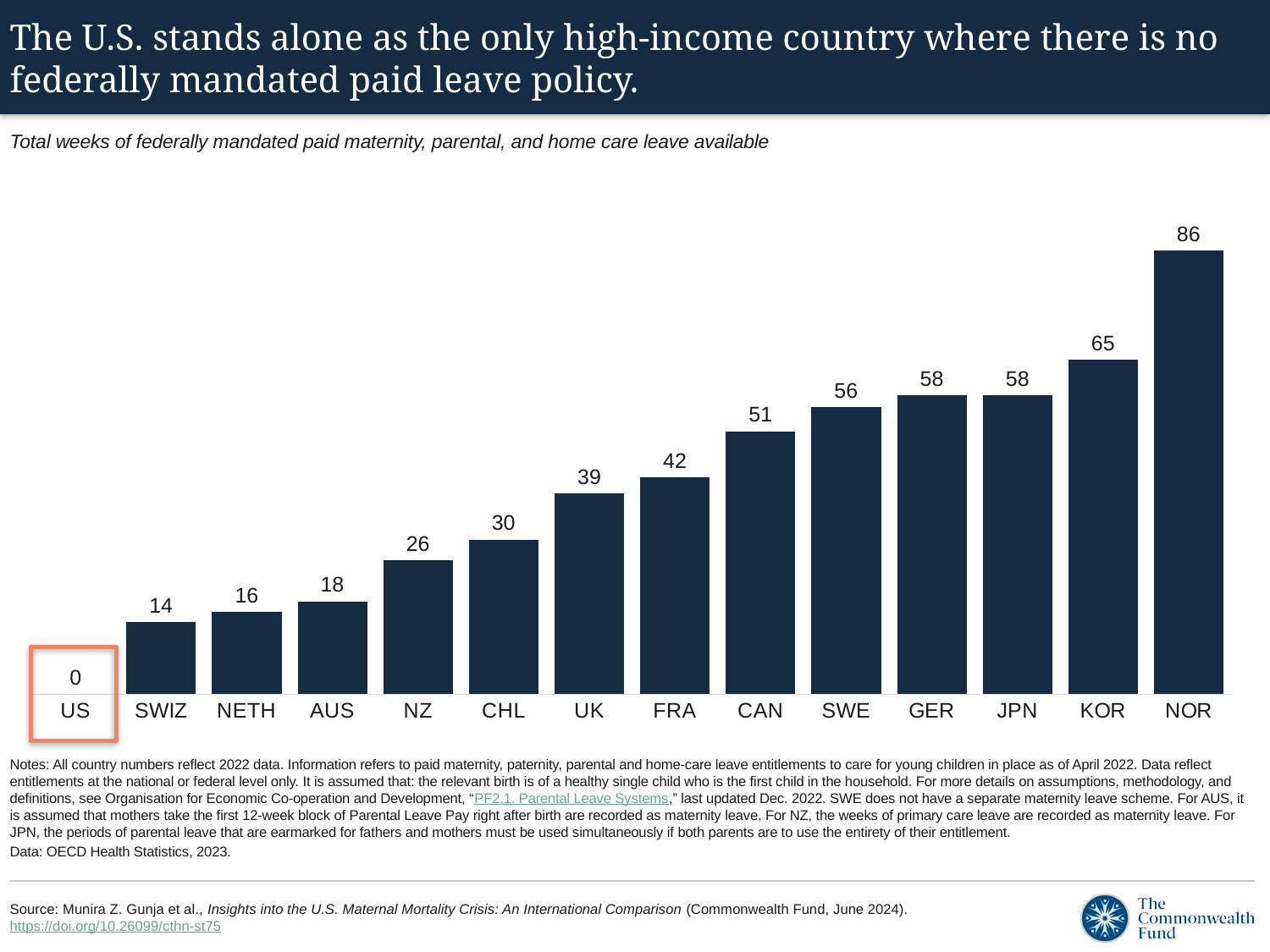
Which country has the lowest value? US What kind of chart is shown on the slide? bar chart Do the values rise or fall from left to right across the countries? rise What is the difference between the values for NOR and KOR? 21 Which is larger, the value for FRA or the value for CHL? FRA What is the difference between the values for UK and SWIZ? 25 What is the value for NOR? 86 What is the value for CAN? 51 Which country has the highest value? NOR What is the value for US? 0 What is the subtitle describing what the chart measures? Total weeks of federally mandated paid maternity, parental, and home care leave available How many countries are shown in the chart? 14